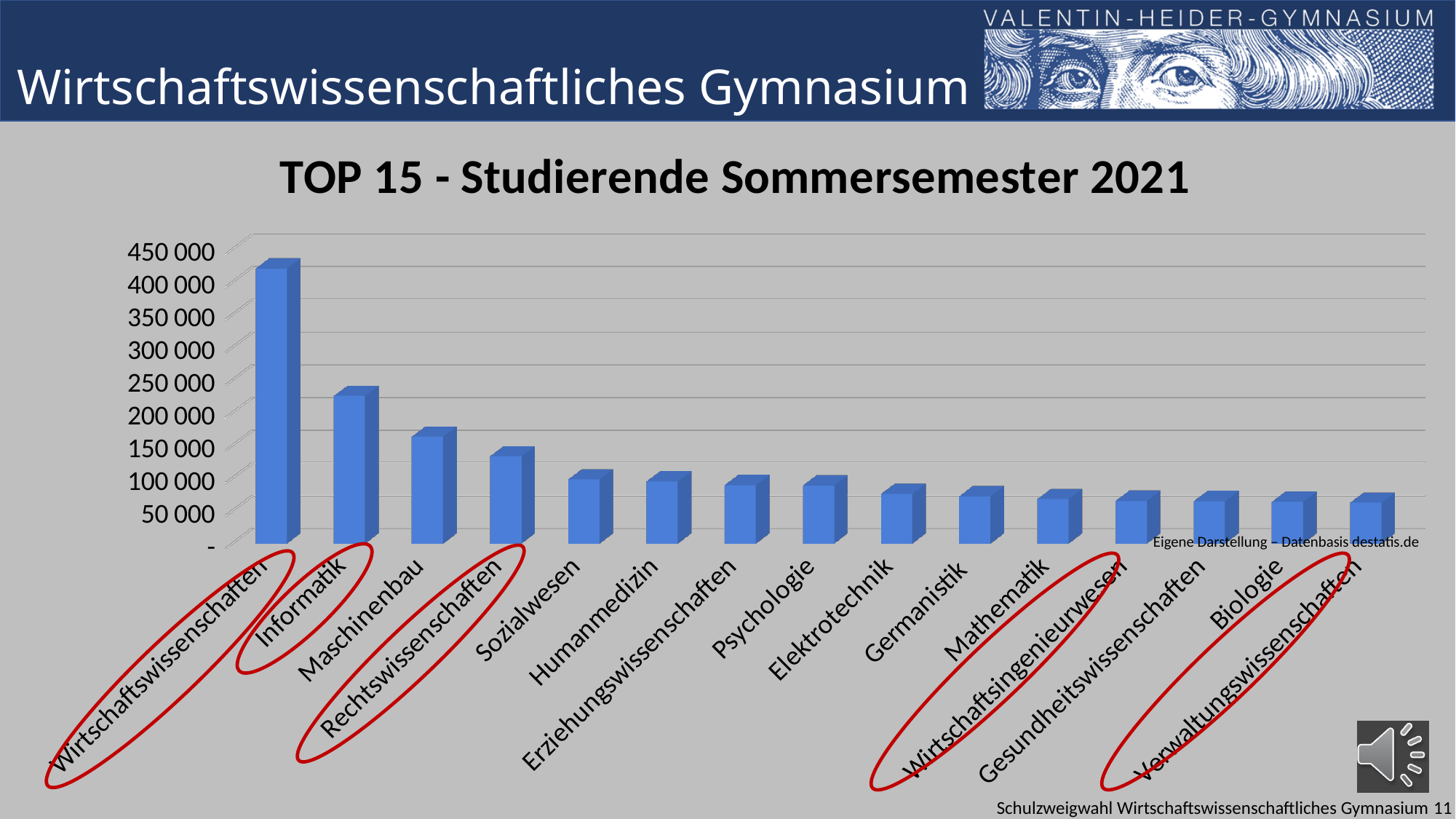
Do the values rise or fall from left to right along the x axis? fall Is the value for Wirtschaftswissenschaften greater or less than 400 000? greater How many categories (subjects) are shown on the x axis? 15 Is the value for Informatik greater or less than 200 000? greater Is the value for Rechtswissenschaften greater or less than 150 000? less What is the title of the chart? TOP 15 - Studierende Sommersemester 2021 Which subject has the highest number of students? Wirtschaftswissenschaften What kind of chart is shown on the slide? bar chart Which has more students, Informatik or Maschinenbau? Informatik What is the highest value shown on the vertical axis? 450 000